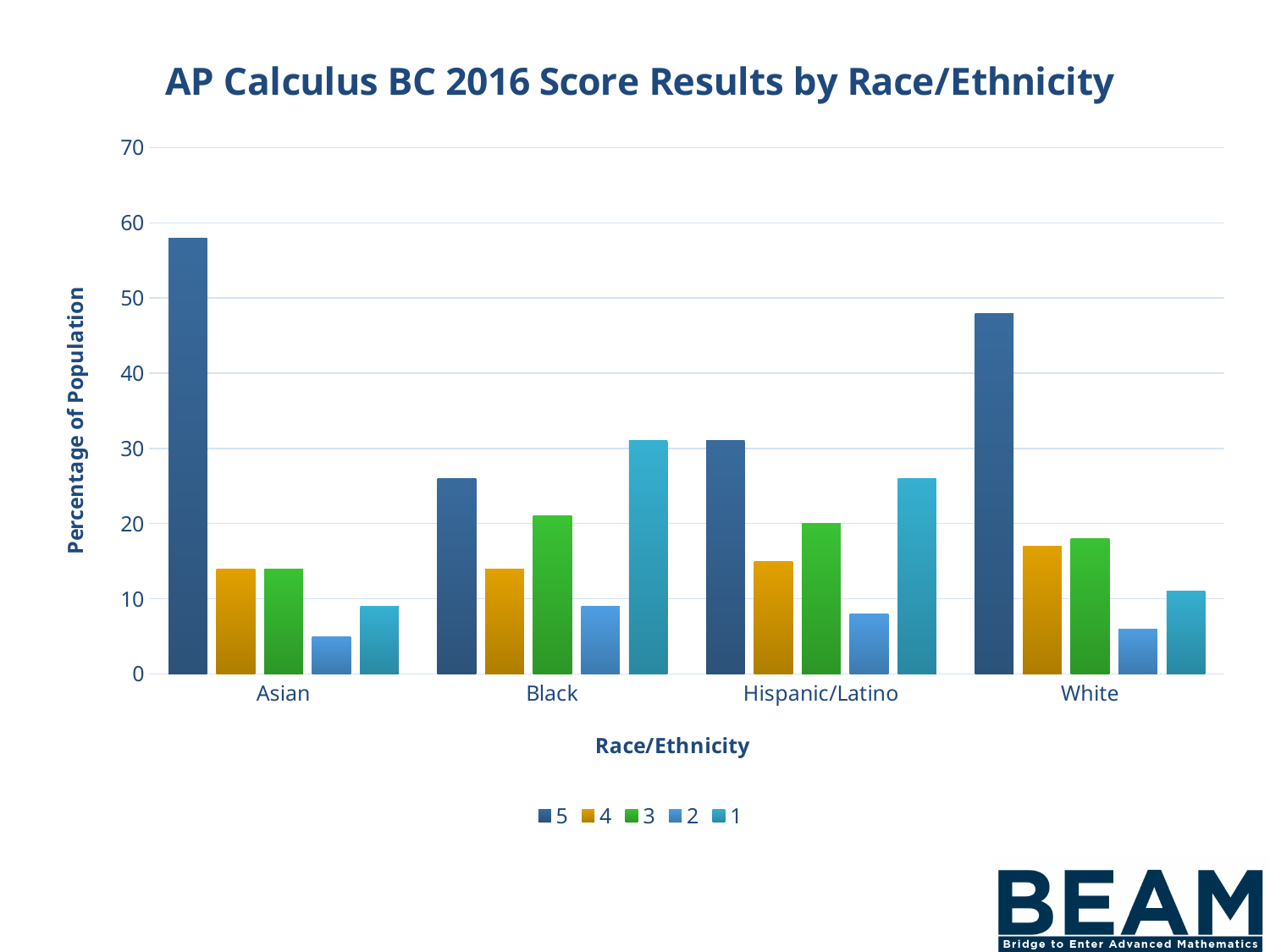
Which race/ethnicity category has the highest bar for score 1? Black Is the value for score 2 in the Asian category greater or less than 10? less How many series does the legend list? 5 What is the title of the chart? AP Calculus BC 2016 Score Results by Race/Ethnicity What kind of chart is shown on the slide? bar chart Which race/ethnicity category has the lowest bar for score 5? Black Which is larger for the Hispanic/Latino category: the bar for score 5 or the bar for score 1? score 5 How many race/ethnicity categories are shown on the x axis? 4 Is the value for score 5 in the White category greater or less than 50? less Is the value for score 5 in the Asian category greater or less than 50? greater Which race/ethnicity category has the highest bar for score 5? Asian